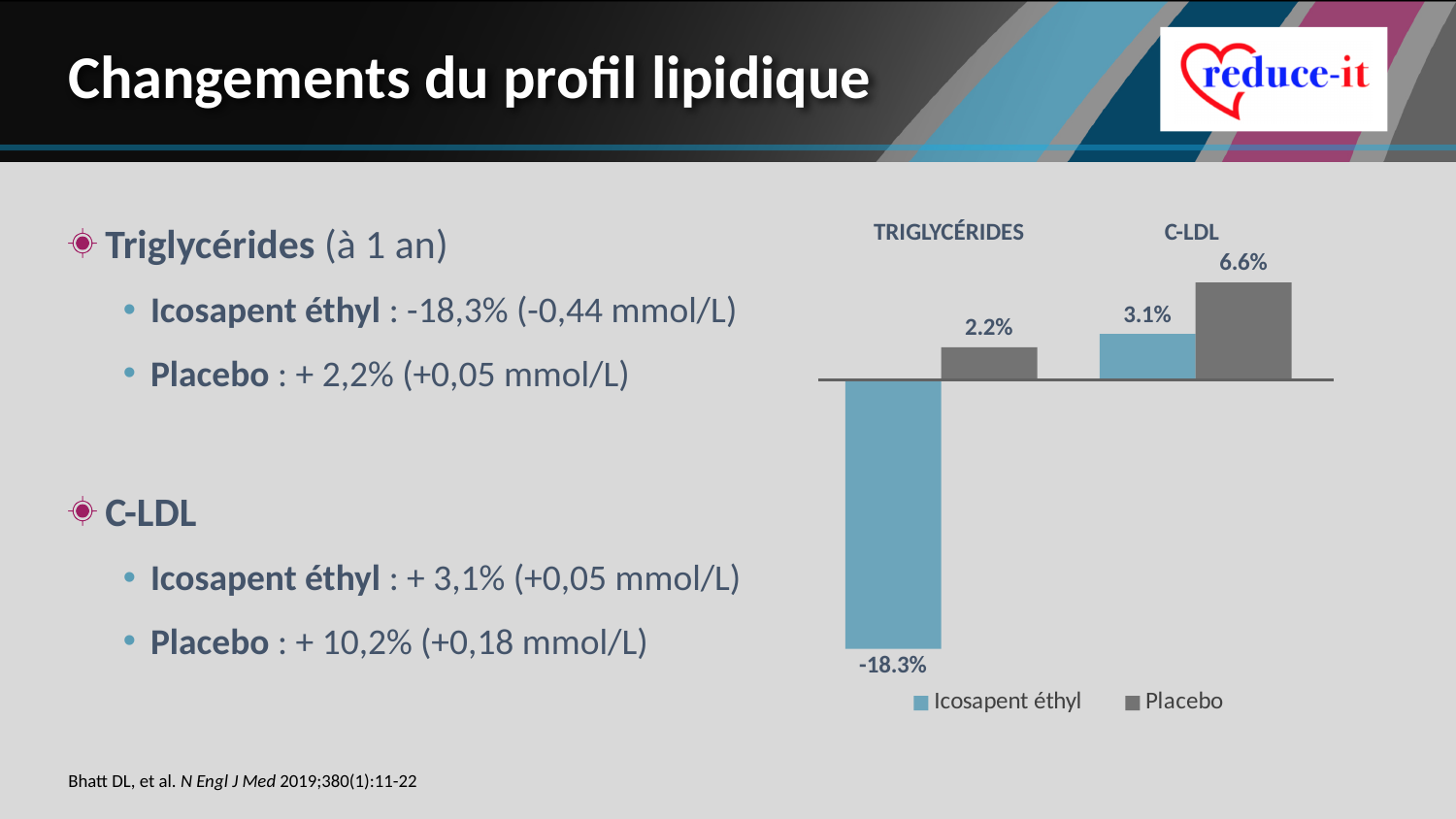
What is the value for Placebo in the C-LDL category? 6.6% What is the value for Icosapent éthyl in the TRIGLYCÉRIDES category? -18.3% What is the value for Icosapent éthyl in the C-LDL category? 3.1% What is the difference between the Placebo and Icosapent éthyl values in the C-LDL category? 3.5% In the C-LDL category, which series has the larger value, Icosapent éthyl or Placebo? Placebo How many series does the chart legend list? 2 Which bar in the chart has the highest value? Placebo, C-LDL How many categories are shown on the chart? 2 What kind of chart is shown on the slide? Bar chart Which bar in the chart has the lowest value? Icosapent éthyl, TRIGLYCÉRIDES What is the value for Placebo in the TRIGLYCÉRIDES category? 2.2% Which colour represents Placebo in the chart? Grey